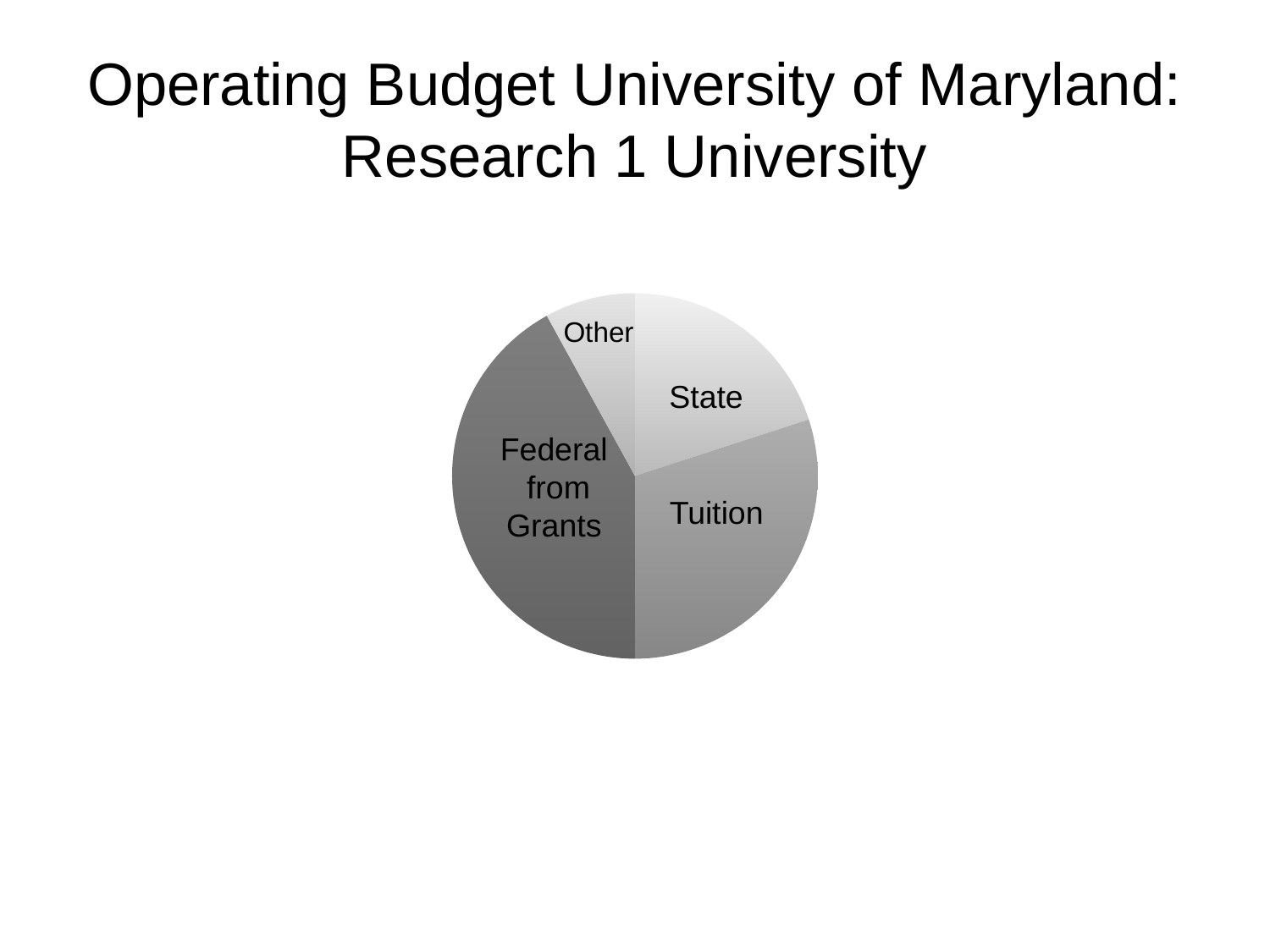
Which is larger, the Federal from Grants slice or the Tuition slice? Federal from Grants What kind of chart is shown on the slide? Pie chart How many slices does the pie chart have? 4 Which slice of the pie chart is the largest? Federal from Grants Which slice of the pie chart is the smallest? Other What is the title of the slide containing the pie chart? Operating Budget University of Maryland: Research 1 University Which is larger, the Tuition slice or the Other slice? Tuition Which is larger, the Federal from Grants slice or the Other slice? Federal from Grants Which slice of the pie chart is shaded the darkest? Federal from Grants